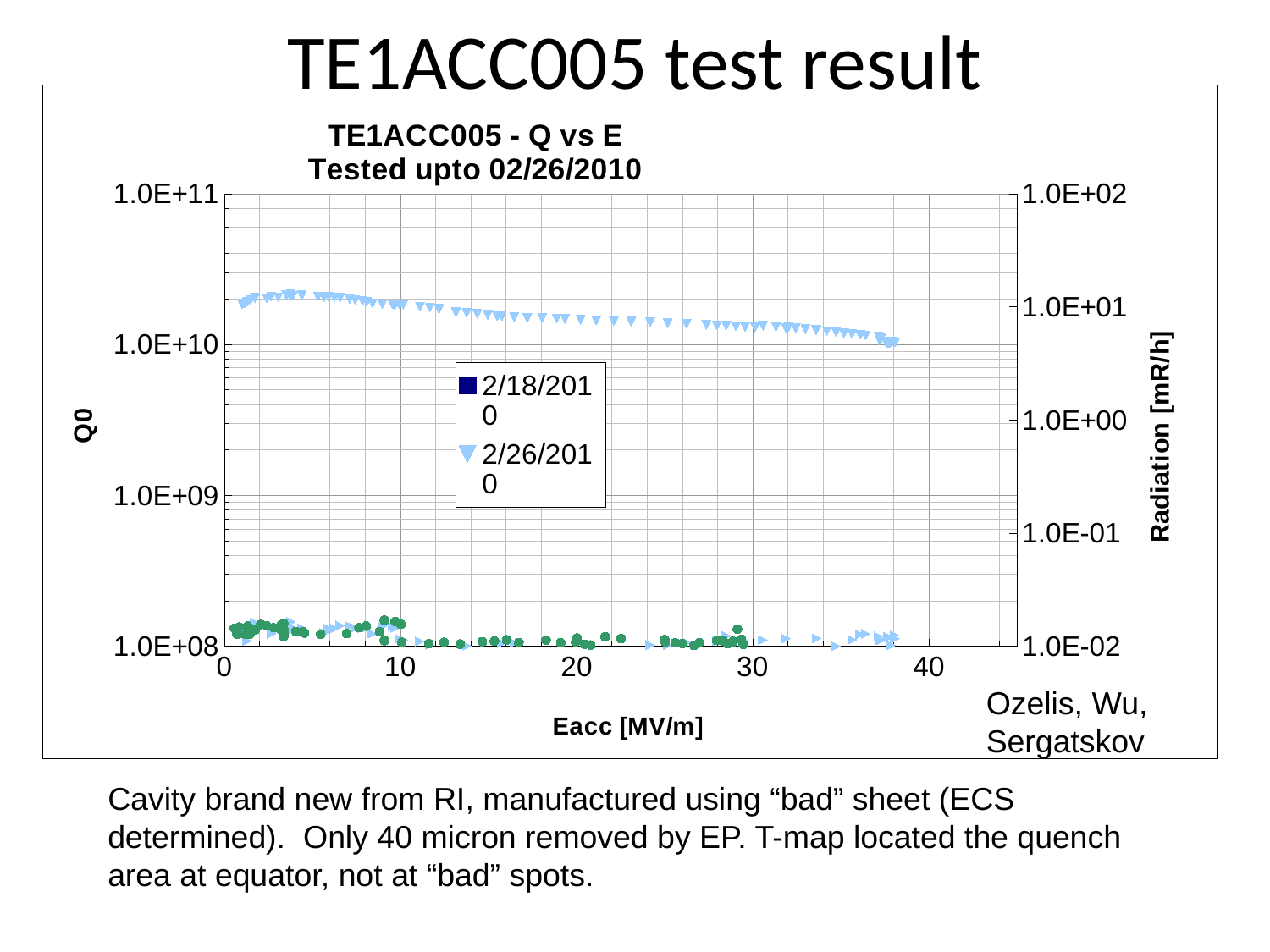
What is the label of the x axis? Eacc [MV/m] Is the Q0 value of the 2/26/2010 series at Eacc = 20 MV/m greater or less than 1.0E+10? greater Is the Q0 value of the 2/26/2010 series at Eacc = 5 MV/m greater or less than 1.0E+10? greater Is the highest Q0 value of the 2/26/2010 series greater or less than 1.0E+11? less How many series does the legend list? 2 What is the title of the chart? TE1ACC005 - Q vs E Tested upto 02/26/2010 Does the Q0 value of the 2/26/2010 series rise or fall as Eacc increases from 10 to 35 MV/m? fall What kind of chart is shown on the slide? scatter chart Which series is plotted with light blue triangle markers? 2/26/2010